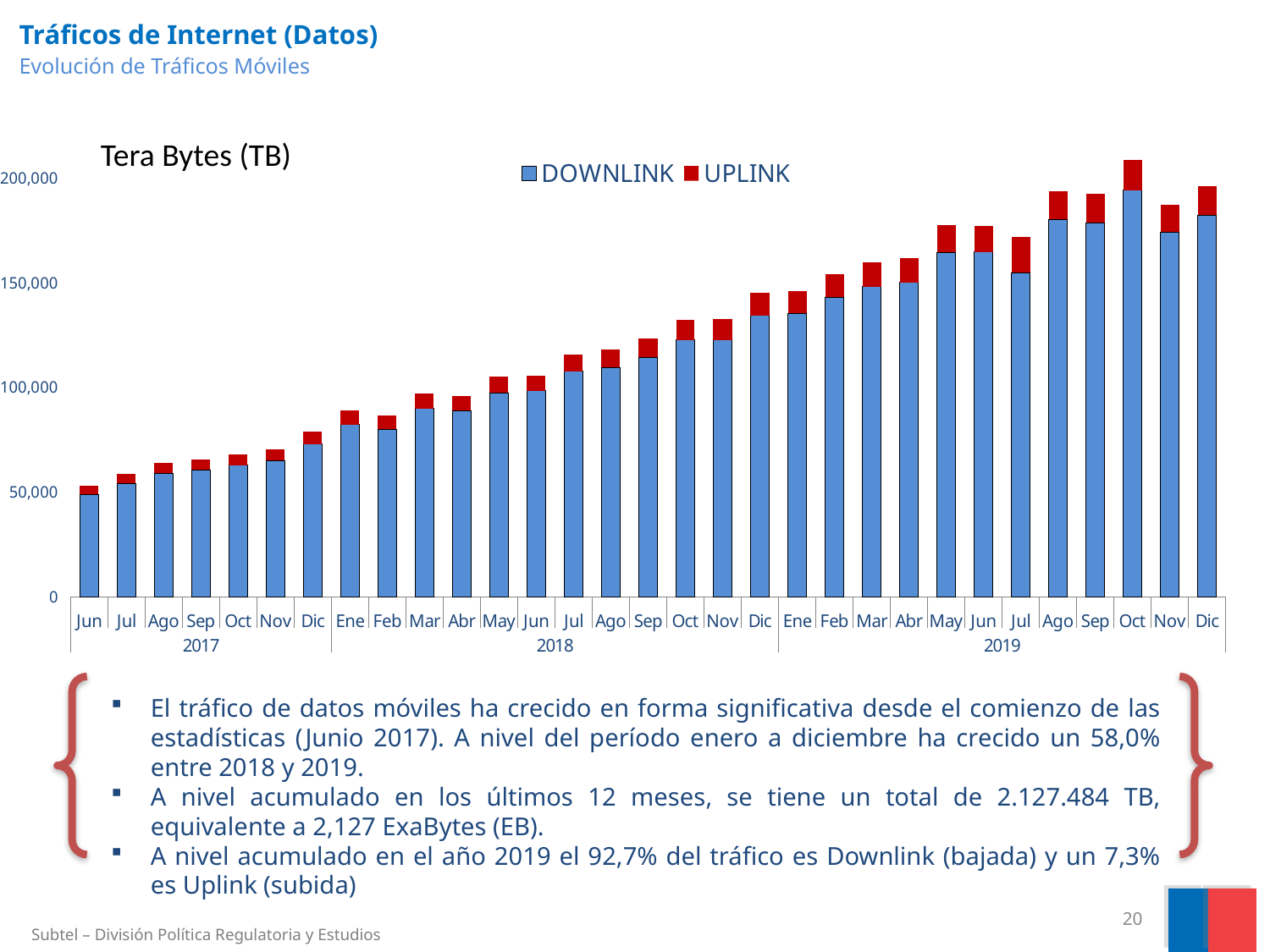
Which month has the larger total traffic, Jul 2019 or Ago 2019? Ago 2019 What kind of chart is shown on the slide? Stacked bar chart Which month has the highest total traffic in the chart? Oct 2019 Which month has the lowest total traffic in the chart? Jun 2017 How many series does the chart legend list? 2 What is the title shown above the chart's vertical axis? Tera Bytes (TB) Do the total traffic values generally rise or fall from Jun 2017 to Dic 2019? Rise Is the DOWNLINK value for Dic 2018 greater or less than 150,000? less Which series is shown in red in the chart? UPLINK How many monthly bars are plotted in the chart? 31 Is the total traffic (DOWNLINK plus UPLINK) for Oct 2019 greater or less than 200,000? greater